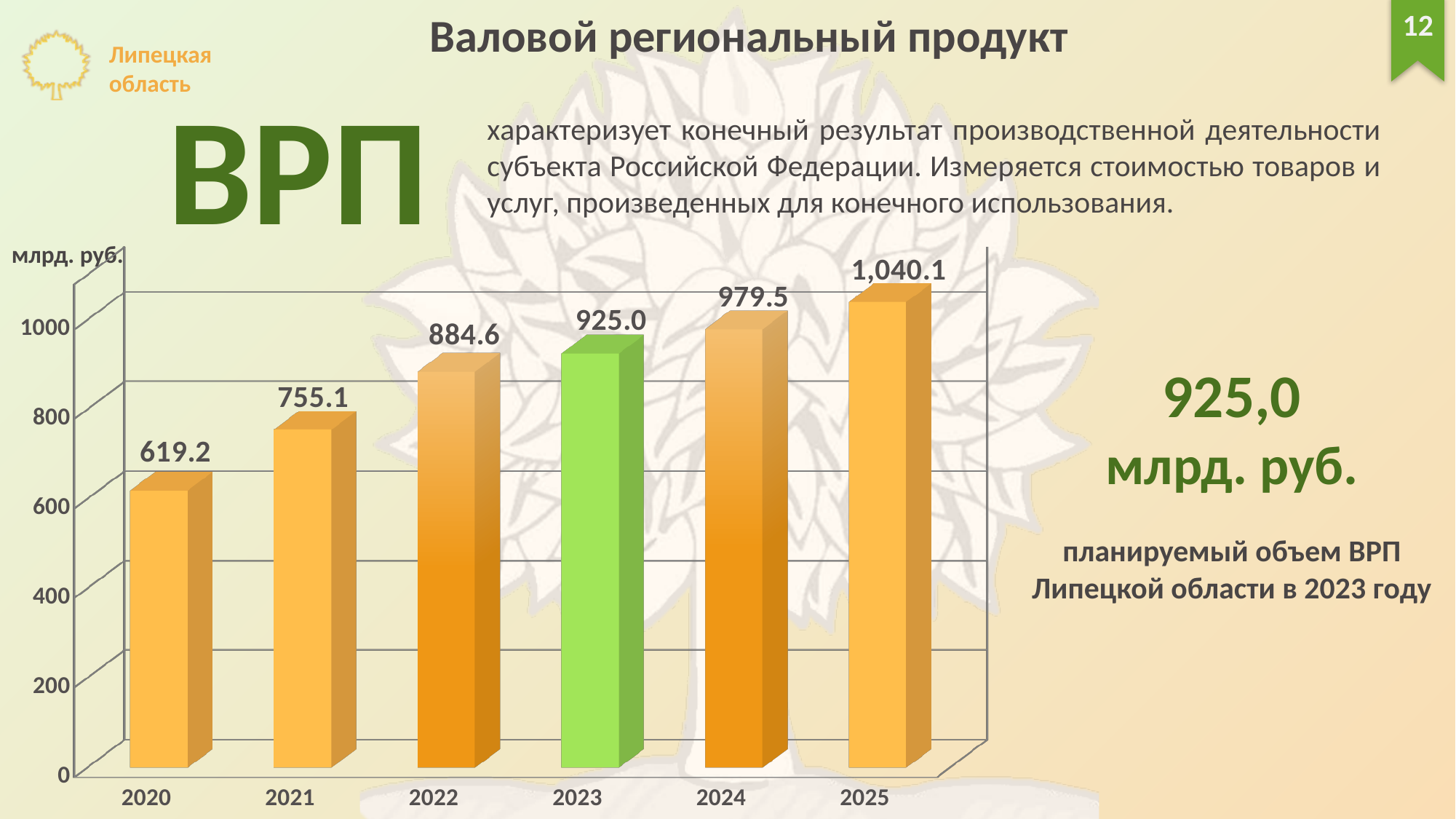
Which year has the highest value? 2025 Do the values rise or fall from 2020 to 2025? rise What is the difference between the values for 2021 and 2020? 135.9 What is the value for 2025? 1,040.1 Which is larger, the value for 2022 or the value for 2024? 2024 Is the value for 2021 greater or less than 800? less How many years are shown on the x axis? 6 What is the value for 2020? 619.2 What is the value for 2023? 925.0 Which year has the lowest value? 2020 What is the difference between the values for 2024 and 2023? 54.5 What kind of chart is shown? bar chart